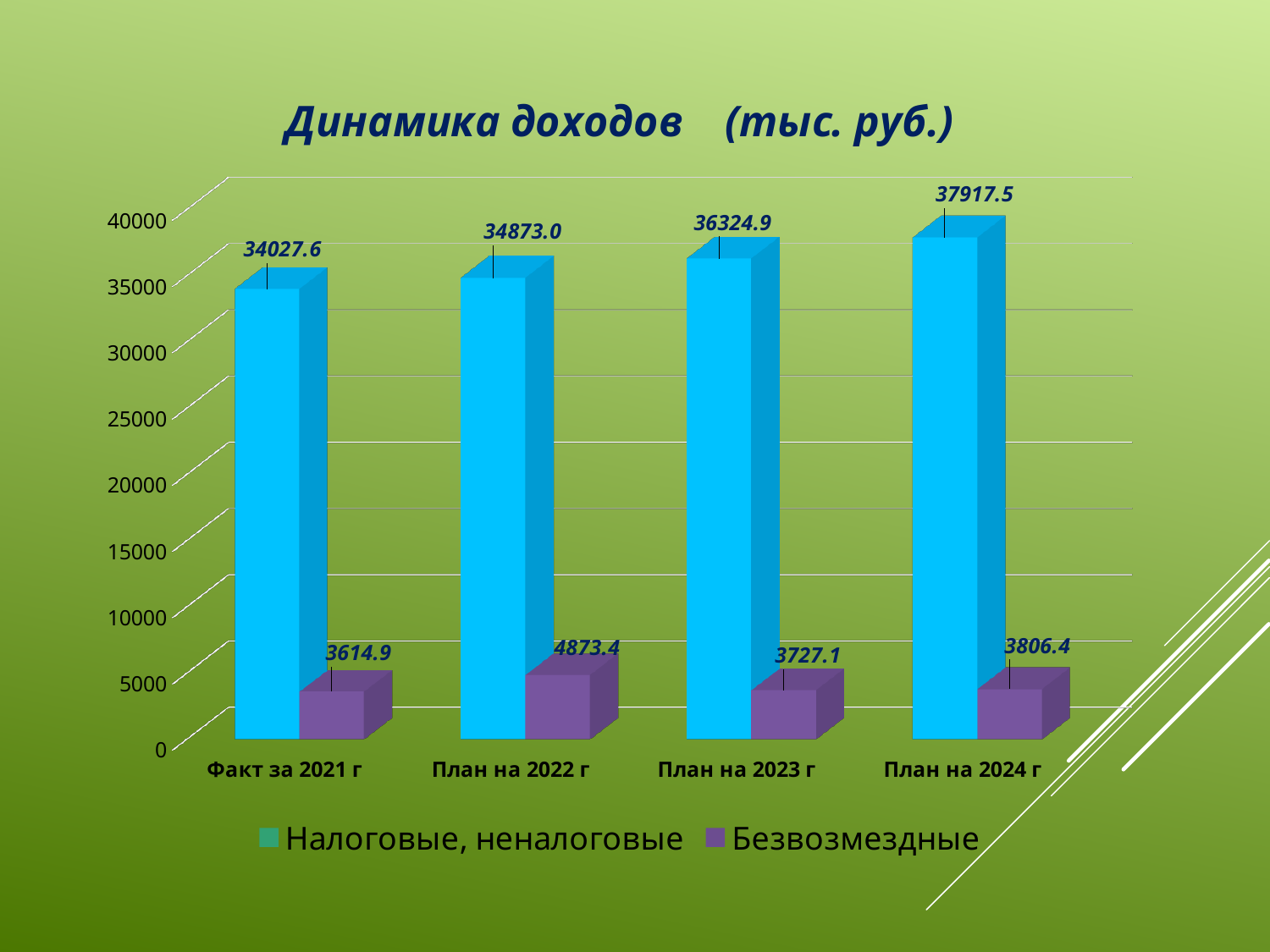
Which is larger: Безвозмездные for План на 2022 г or for План на 2024 г? План на 2022 г How many series does the legend list? 2 What is the value of Безвозмездные for План на 2022 г? 4873.4 What is the value of Налоговые, неналоговые for План на 2024 г? 37917.5 What is the difference between the Налоговые, неналоговые values for План на 2024 г and Факт за 2021 г? 3889.9 Which category has the highest value for Безвозмездные? План на 2022 г Do the Налоговые, неналоговые values rise or fall from Факт за 2021 г to План на 2024 г? rise Which category has the lowest value for Налоговые, неналоговые? Факт за 2021 г Is the value of Налоговые, неналоговые for План на 2023 г greater or less than 35000? greater What is the value of Налоговые, неналоговые for Факт за 2021 г? 34027.6 How many categories are shown on the x axis? 4 What is the value of Безвозмездные for План на 2023 г? 3727.1